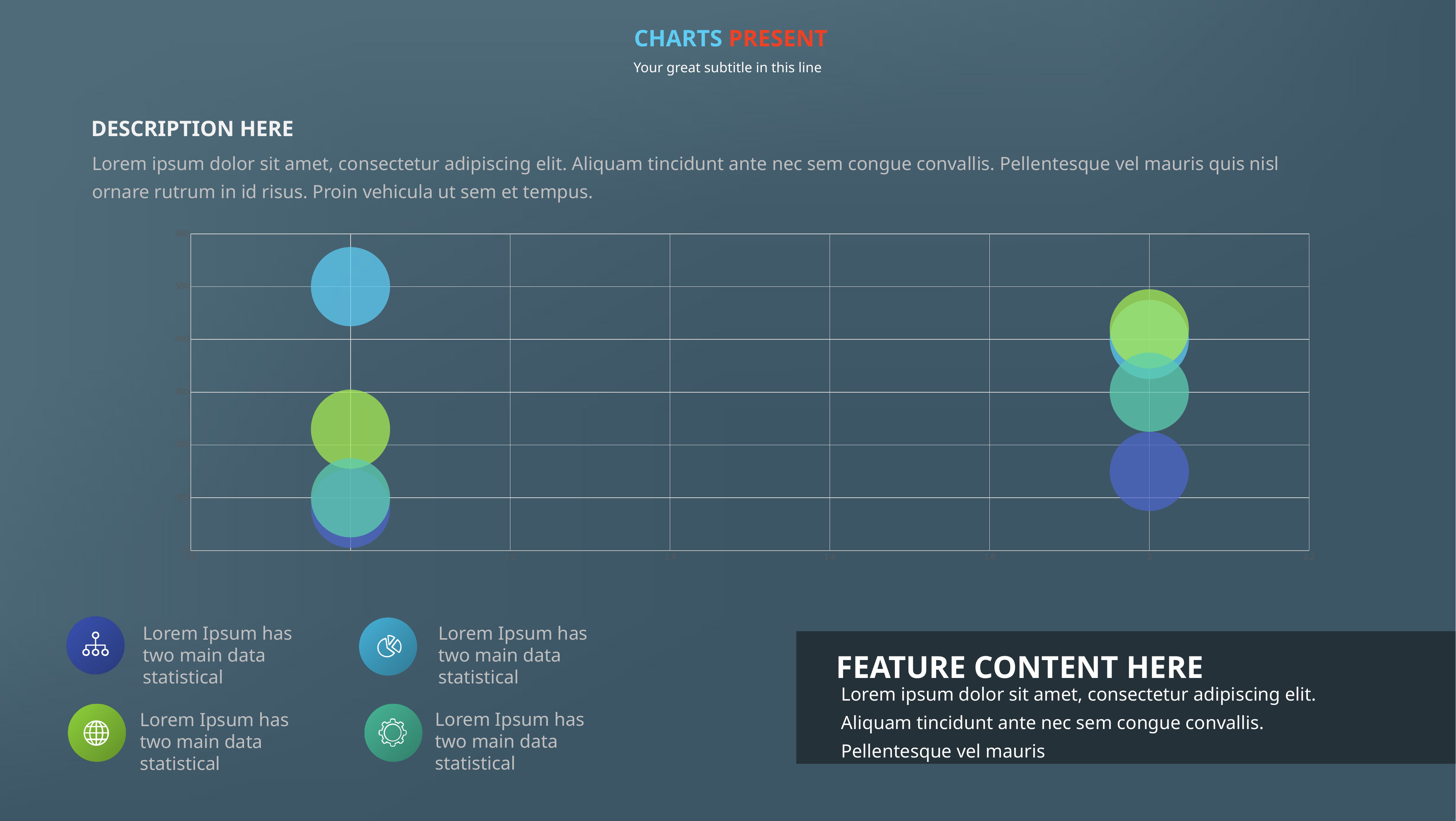
In the left group of bubbles, which is higher: the light blue bubble or the green bubble? light blue How many bubbles are plotted on the chart? 8 What kind of chart is shown on the slide? bubble chart How many vertical groups of bubbles are there on the chart? 2 Does the chart display a legend? No In the left group of bubbles, which is higher: the green bubble or the teal bubble? green How many different bubble colours appear on the chart? 4 Which colour bubble is positioned highest on the chart? light blue In the right group of bubbles, which is higher: the green bubble or the dark blue bubble? green Which colour bubble is positioned lowest on the chart? dark blue